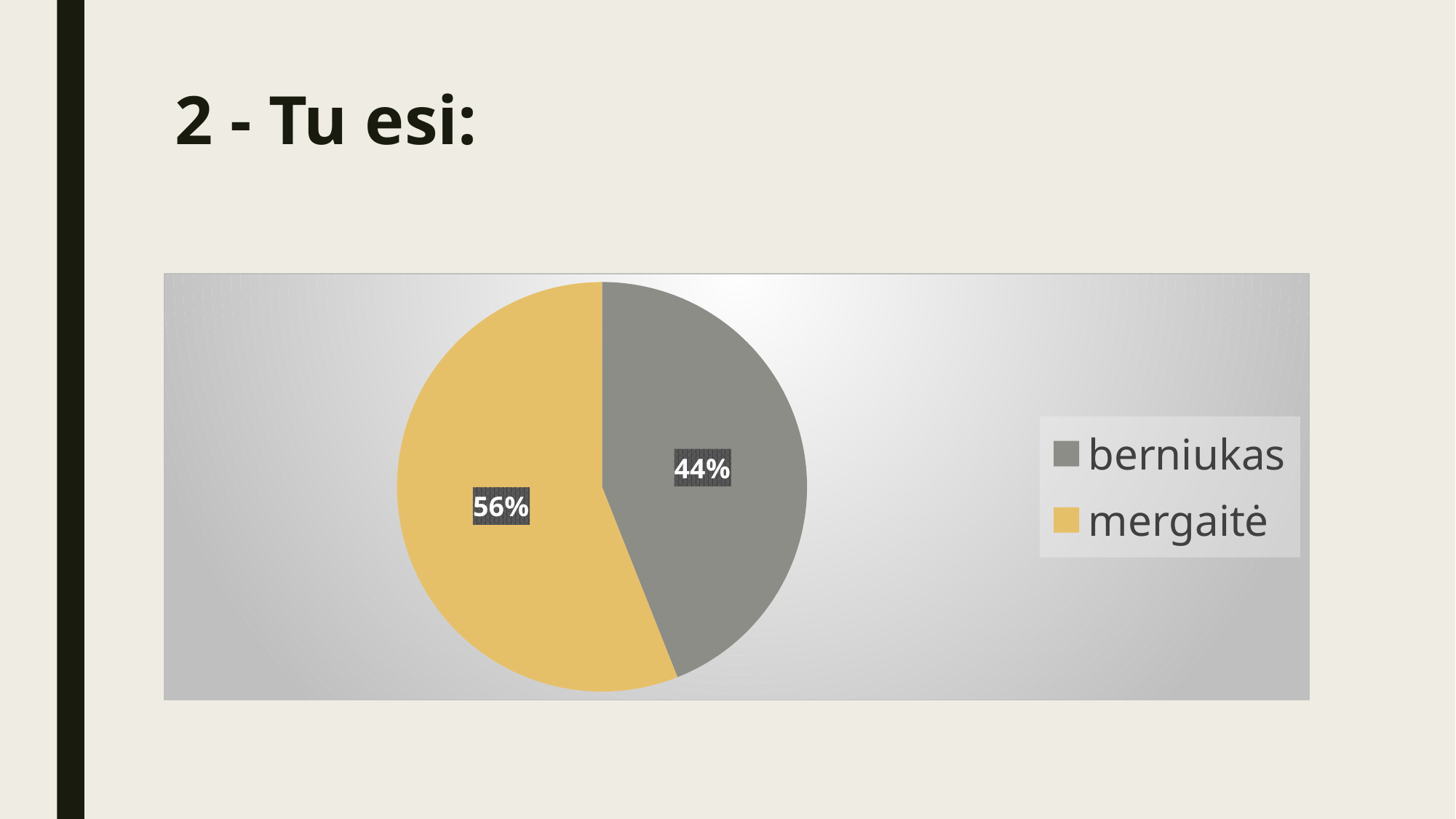
What kind of chart is shown on the slide? pie chart What is the difference in percentage points between the 'mergaitė' and 'berniukas' slices? 12 Which is larger, the share for 'berniukas' or the share for 'mergaitė'? mergaitė What percentage of the pie is labelled 'berniukas'? 44% How many entries does the legend list? 2 What percentage of the pie is labelled 'mergaitė'? 56% How many slices does the pie chart have? 2 Which category has the largest share of the pie? mergaitė Which category has the smallest share of the pie? berniukas What colour is the 'mergaitė' slice? yellow What is the title of the slide containing the pie chart? 2 - Tu esi: